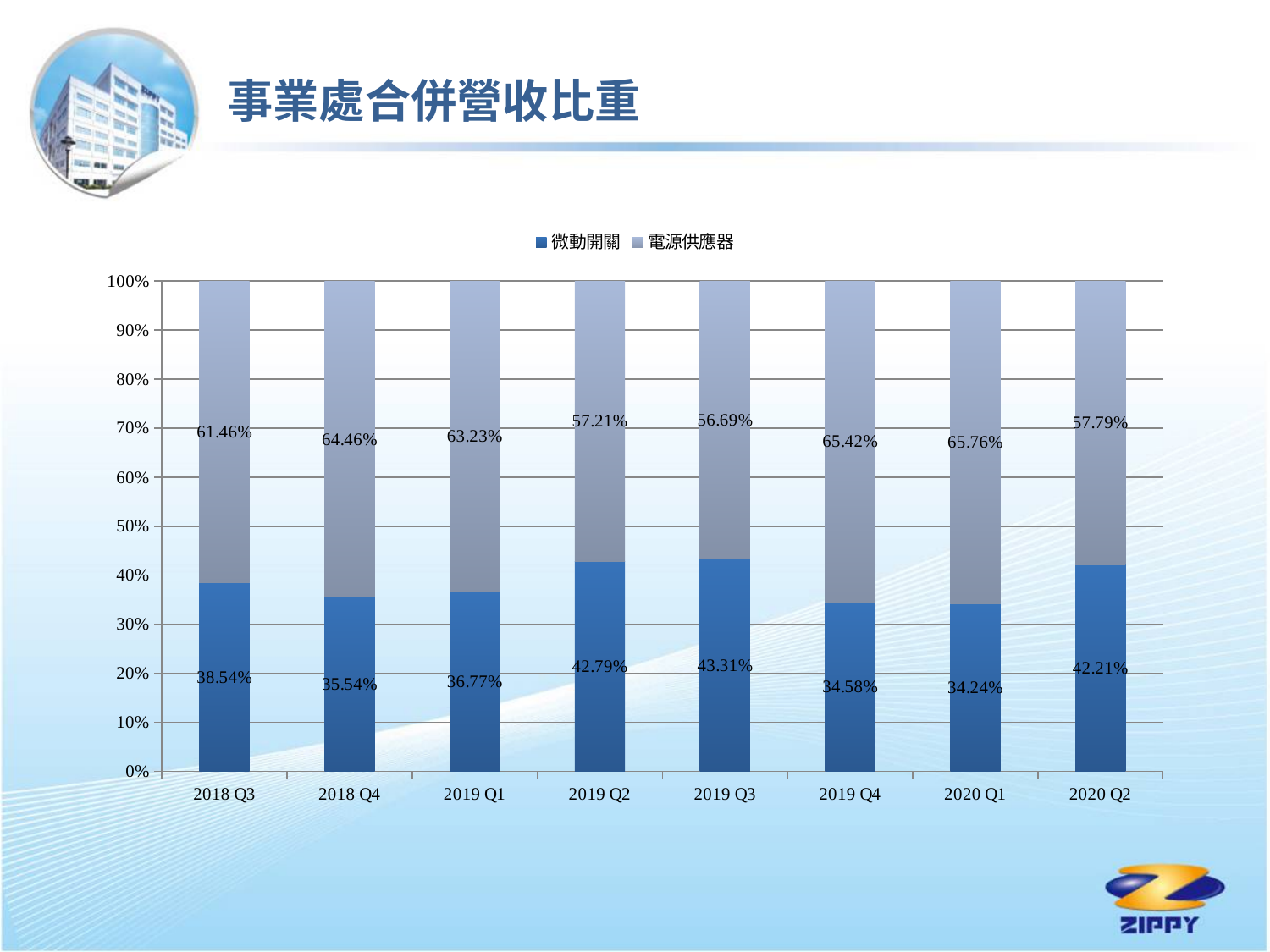
What is the difference between the 微動開關 share in 2019 Q3 and in 2020 Q1? 9.07 percentage points What is the total of the stacked bar for 2019 Q4? 100% What kind of chart is shown on the slide? Stacked bar chart What is the value for 電源供應器 in 2020 Q1? 65.76% In which quarter is the 微動開關 share lowest? 2020 Q1 How many quarters are shown on the x axis? 8 What is the value for 微動開關 in 2019 Q2? 42.79% How many series does the legend list? 2 What is the value for 微動開關 in 2018 Q3? 38.54% Which is larger in 2020 Q2: the 微動開關 share or the 電源供應器 share? 電源供應器 In which quarter is the 電源供應器 share highest? 2020 Q1 In which quarter is the 微動開關 share highest? 2019 Q3